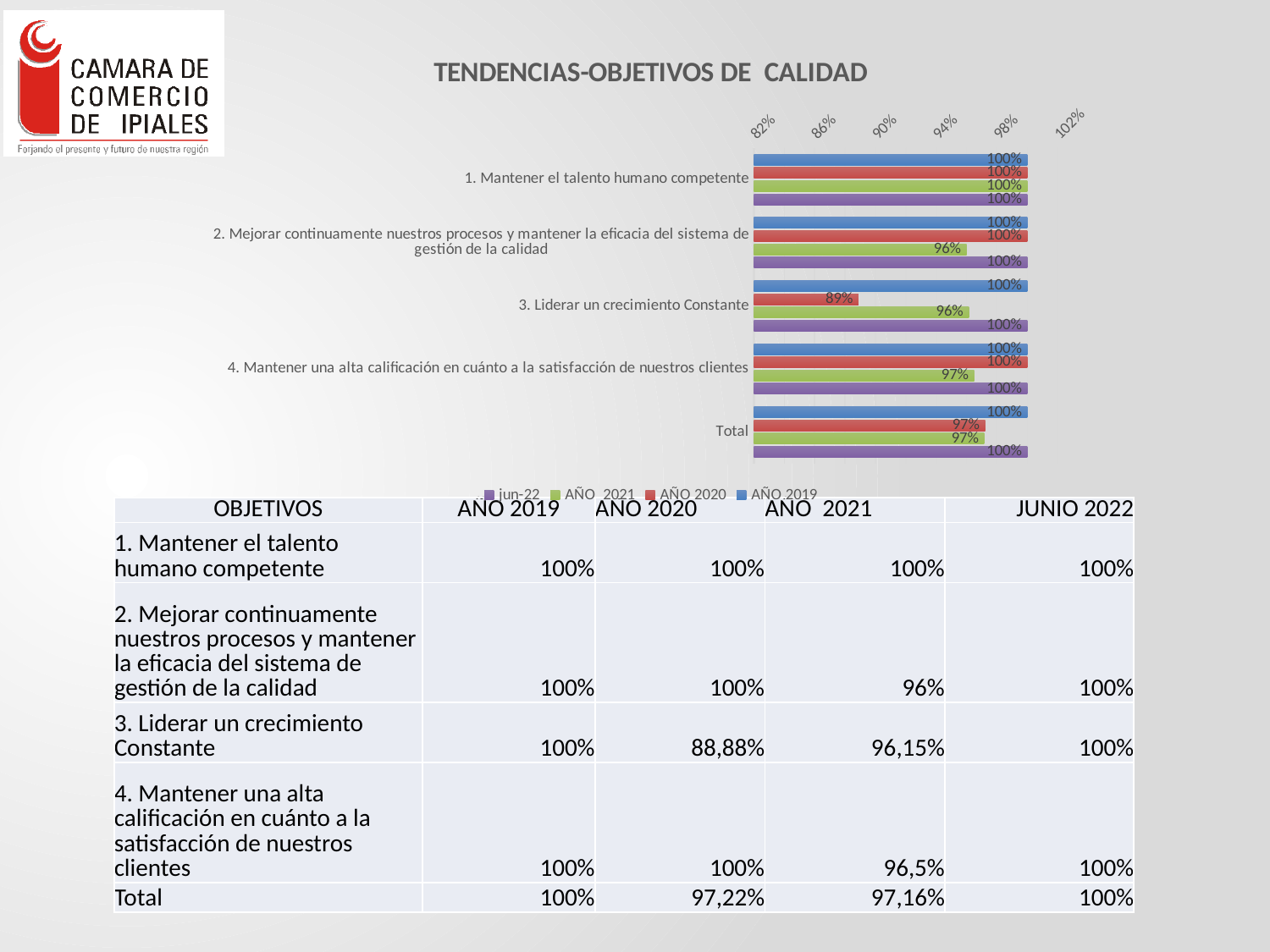
How many series does the chart legend list? 4 Using the chart's data labels, what is the difference between the AÑO 2019 and AÑO 2020 values for '3. Liderar un crecimiento Constante'? 11% According to the chart's data label, what is the AÑO 2021 value for '4. Mantener una alta calificación en cuánto a la satisfacción de nuestros clientes'? 97% For '3. Liderar un crecimiento Constante', which is larger on the chart: the AÑO 2021 value or the AÑO 2020 value? AÑO 2021 According to the chart's data label, what is the AÑO 2020 value for '3. Liderar un crecimiento Constante'? 89% What type of chart is shown on the slide? bar chart According to the chart's data label, what is the AÑO 2021 value for '2. Mejorar continuamente nuestros procesos y mantener la eficacia del sistema de gestión de la calidad'? 96% Which category has the lowest AÑO 2020 value on the chart? 3. Liderar un crecimiento Constante Which series is shown in purple on the chart? jun-22 How many categories are plotted on the chart? 5 According to the chart's data label, what is the AÑO 2020 value for 'Total'? 97% What is the title of the chart? TENDENCIAS-OBJETIVOS DE CALIDAD